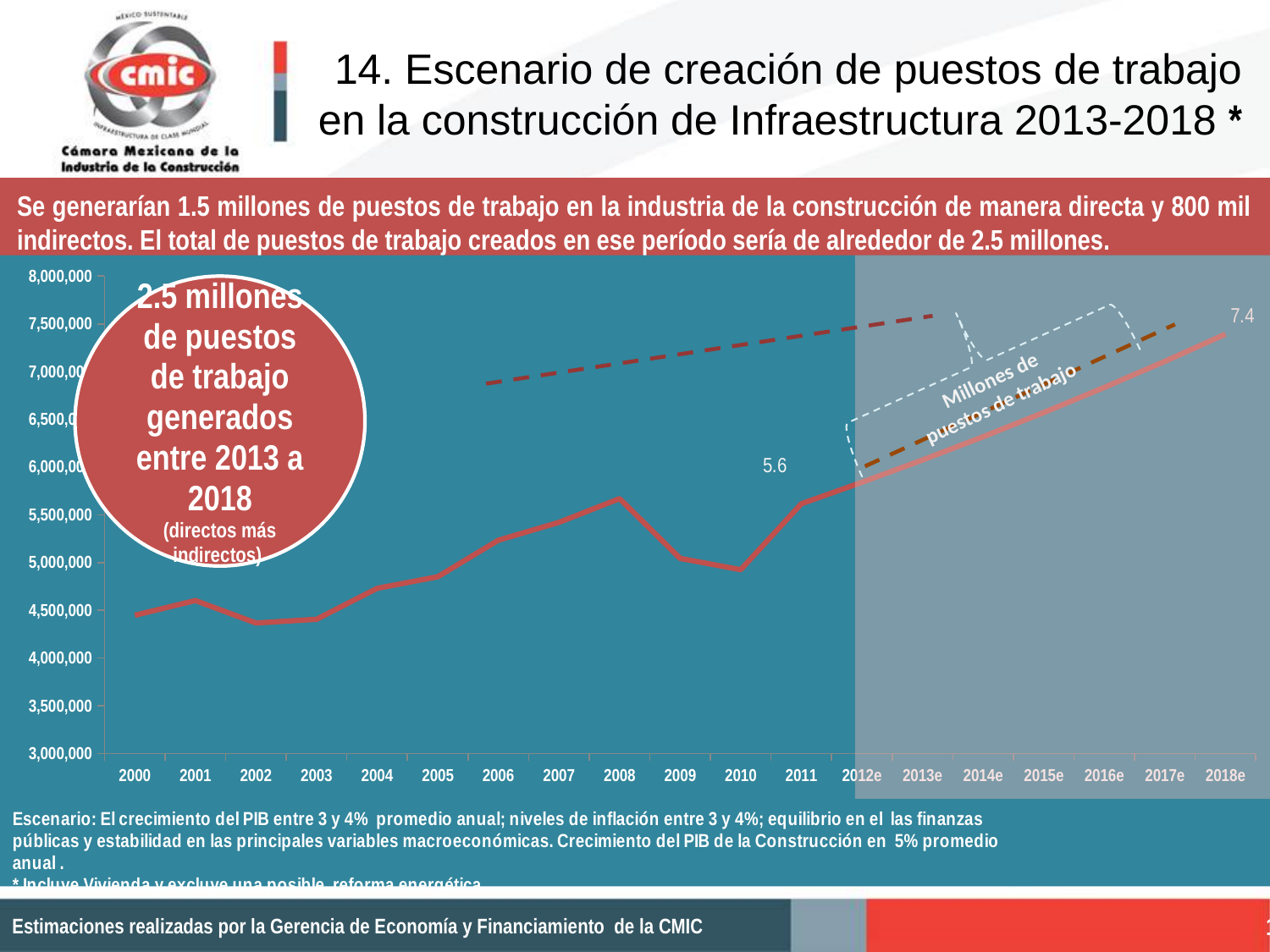
What type of chart is shown on the slide? line chart Is the value for 2010 greater or less than 5,000,000? less Do the values rise or fall from 2012e to 2018e? rise What is the first data label printed on the line, before the shaded projection area? 5.6 Is the value for 2008 greater or less than 5,500,000? greater How many years are shown on the x axis, from 2000 to 2018e? 19 What is the difference between the two labelled values on the line, 7.4 and 5.6? 1.8 Is the value for 2002 greater or less than 4,500,000? less Which year on the x axis has the highest value on the line? 2018e Which year has the larger value, 2008 or 2009? 2008 What value is labelled on the line at 2018e? 7.4 What is the highest tick value shown on the y axis? 8,000,000